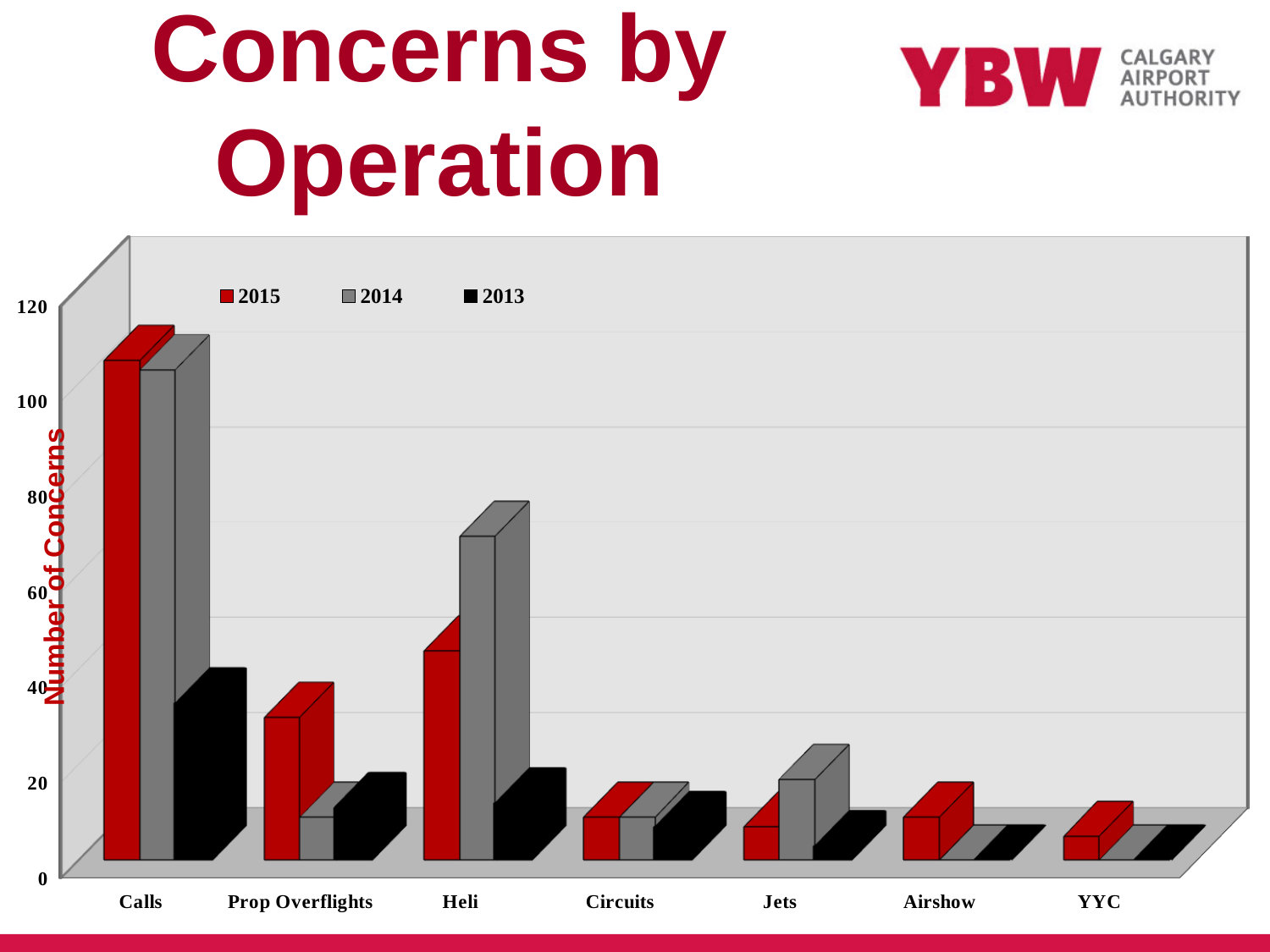
Which category has the highest value for 2015? Calls How many operation categories are shown on the x axis? 7 What is the title of the vertical axis? Number of Concerns Which category has the highest value for 2014? Calls Is the 2014 value for Heli greater or less than 60? greater Is the 2015 value for Prop Overflights greater or less than 40? less What kind of chart is shown on the slide? Bar chart For Heli, which year has the larger value, 2014 or 2015? 2014 How many series does the legend list? 3 Is the 2015 value for Calls greater or less than 100? greater For Calls, which year has the larger value, 2015 or 2013? 2015